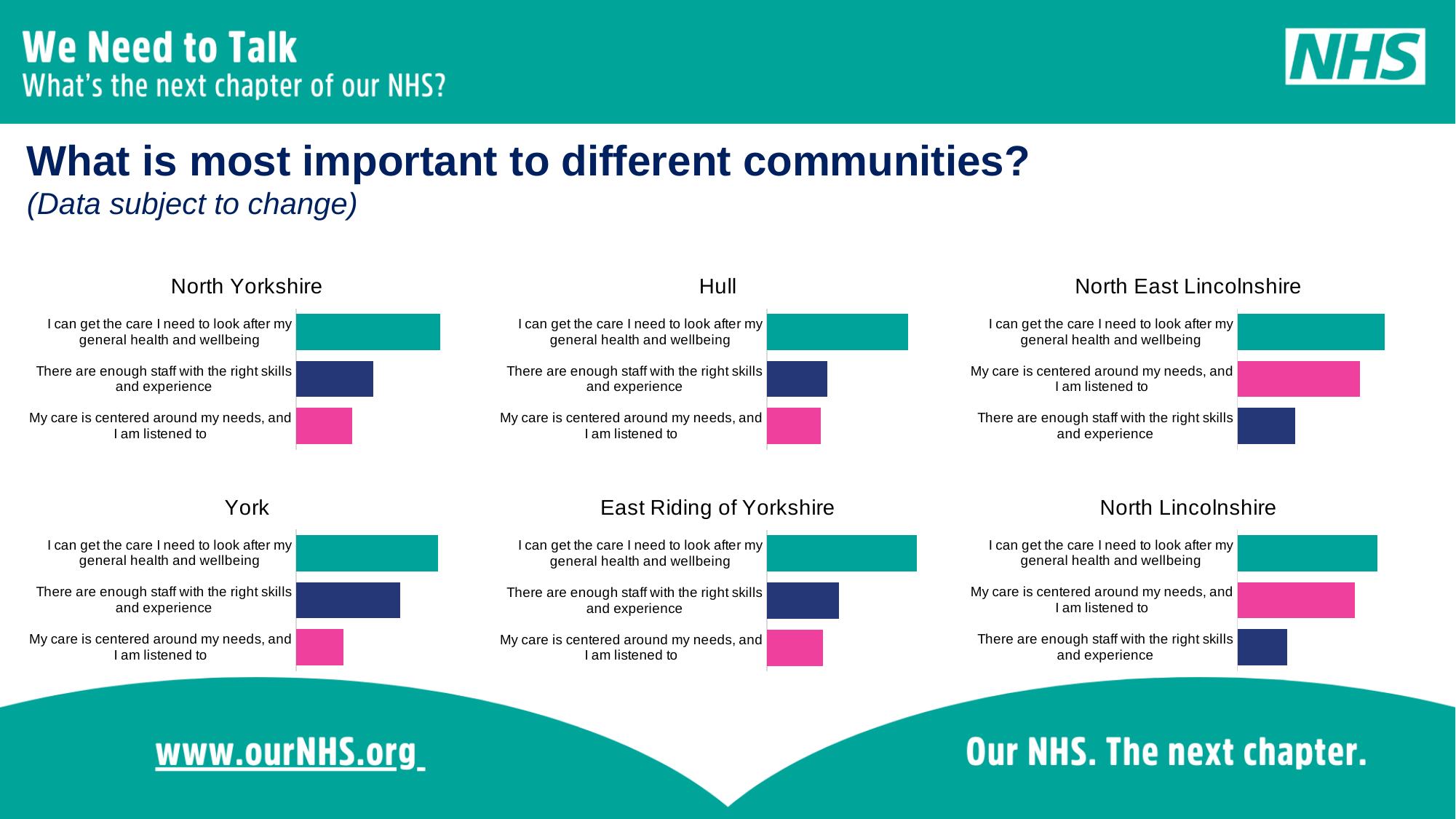
In the North East Lincolnshire chart, which category has the shortest bar? There are enough staff with the right skills and experience In the North Yorkshire chart, which category has the longest bar? I can get the care I need to look after my general health and wellbeing In the North Lincolnshire chart, which category has the longest bar? I can get the care I need to look after my general health and wellbeing In the North Yorkshire chart, which category has the shortest bar? My care is centered around my needs, and I am listened to What kind of chart is the North Yorkshire chart? bar chart What is the title of the chart in the top-right position on the slide? North East Lincolnshire How many categories does the Hull chart show? 3 In the York chart, which is larger: 'There are enough staff with the right skills and experience' or 'My care is centered around my needs, and I am listened to'? There are enough staff with the right skills and experience How many charts are shown on the slide? 6 In the North East Lincolnshire chart, which is larger: 'My care is centered around my needs, and I am listened to' or 'There are enough staff with the right skills and experience'? My care is centered around my needs, and I am listened to In the East Riding of Yorkshire chart, which category has the shortest bar? My care is centered around my needs, and I am listened to In the Hull chart, which category has the longest bar? I can get the care I need to look after my general health and wellbeing